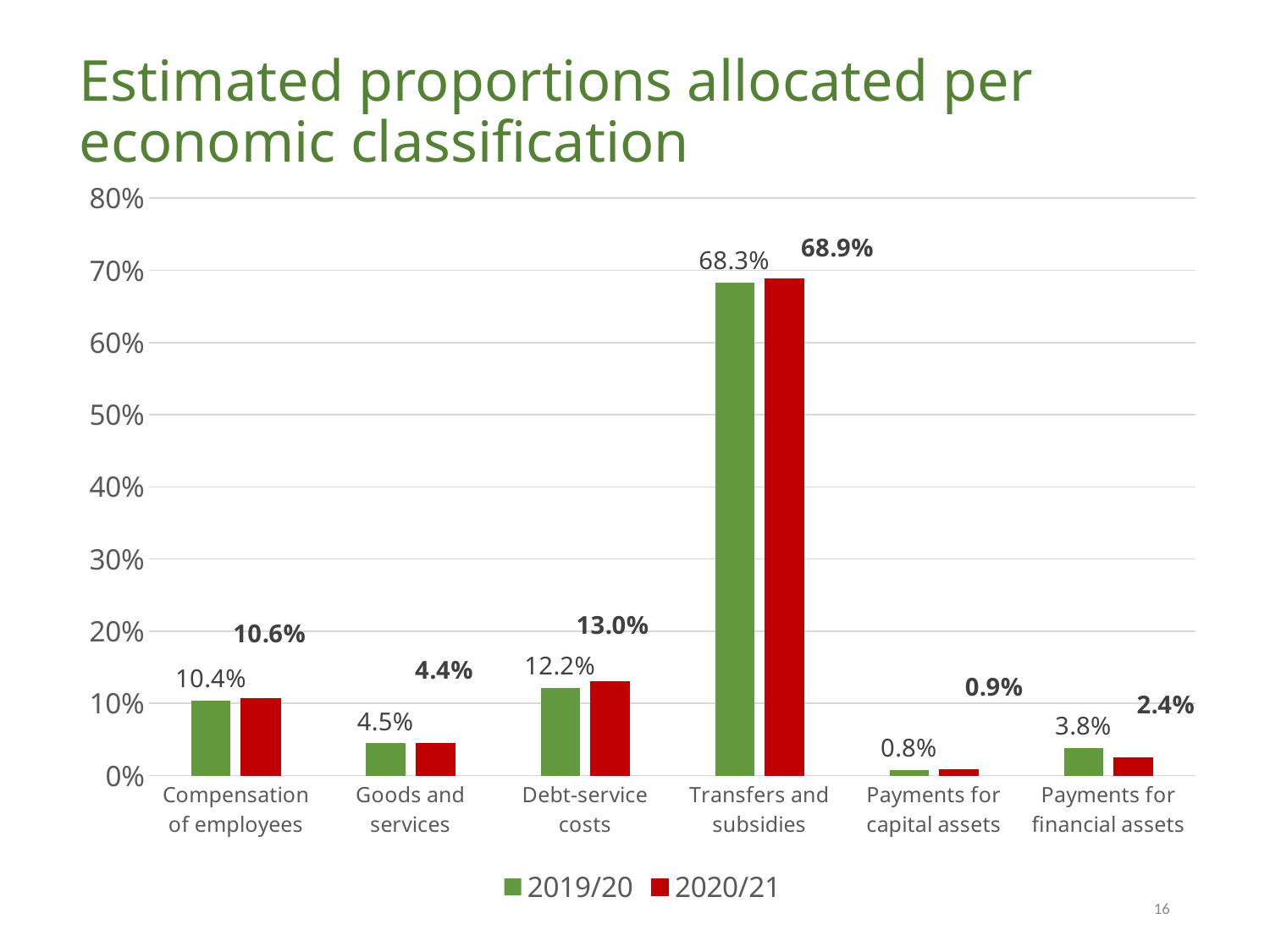
What is the difference between the 2020/21 and 2019/20 values for Transfers and subsidies? 0.6% What kind of chart is shown on the slide? Bar chart Which category has the highest value in 2020/21? Transfers and subsidies Is the 2019/20 value for Transfers and subsidies greater or less than 60%? greater How many categories are shown on the x axis? 6 What is the 2020/21 value for Payments for financial assets? 2.4% Which is larger for Payments for financial assets: the 2019/20 value or the 2020/21 value? 2019/20 What is the 2020/21 value for Debt-service costs? 13.0% How many series does the legend list? 2 What is the title of the chart? Estimated proportions allocated per economic classification What is the 2019/20 value for Compensation of employees? 10.4% Which category has the lowest value in 2019/20? Payments for capital assets